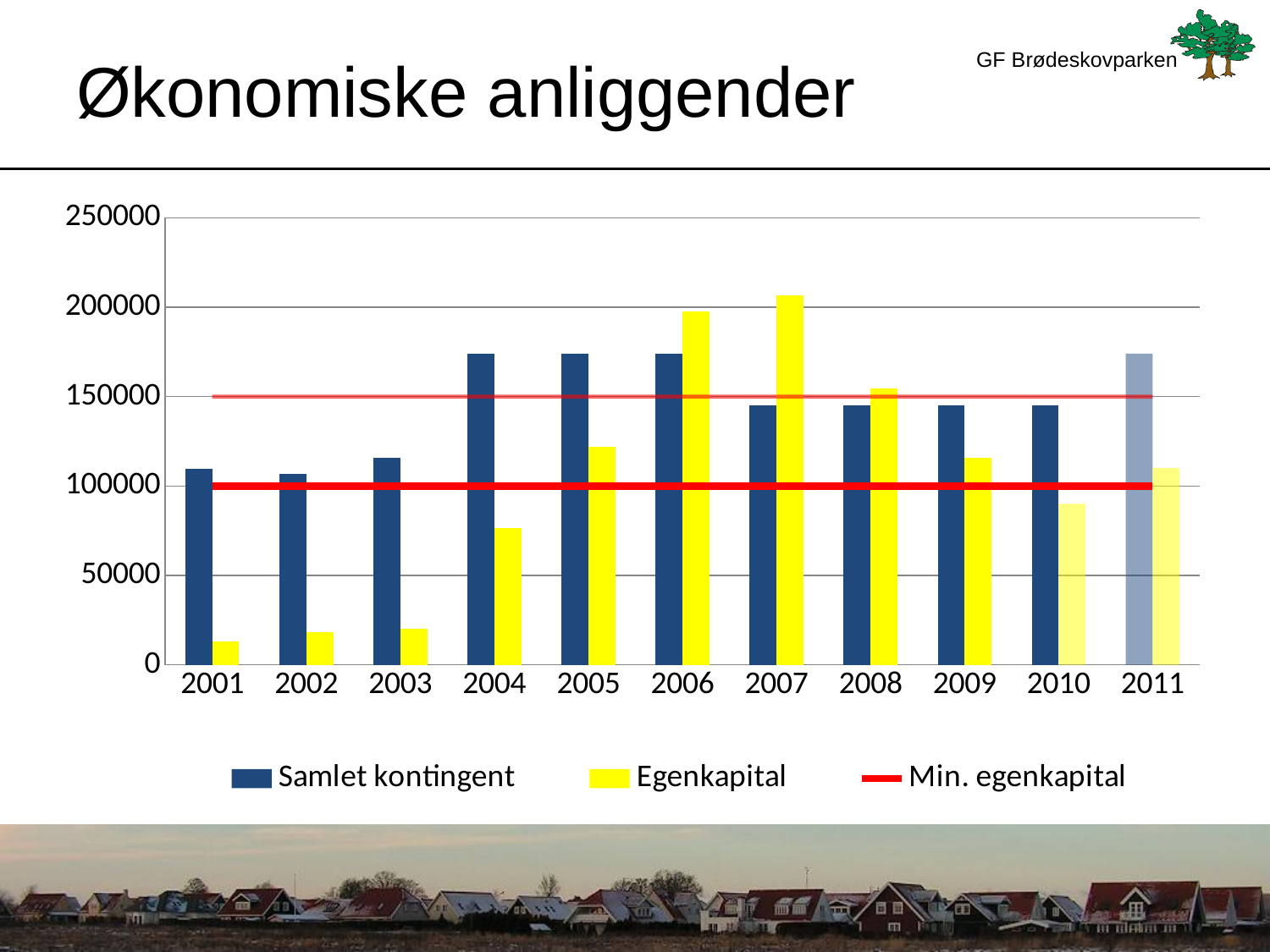
Is the Egenkapital value for 2010 greater or less than 100000? less Is the Egenkapital value for 2007 greater or less than 200000? greater Is the Egenkapital value for 2001 greater or less than 50000? less In which year is Egenkapital highest? 2007 Which legend entry is shown as a red line? Min. egenkapital In 2007, which is larger: Samlet kontingent or Egenkapital? Egenkapital Does Egenkapital rise or fall from 2001 to 2007? Rise How many entries does the chart's legend list? 3 In which year is Egenkapital lowest? 2001 How many years are shown on the x axis of the chart? 11 What kind of chart is shown on the slide? Combination bar and line chart